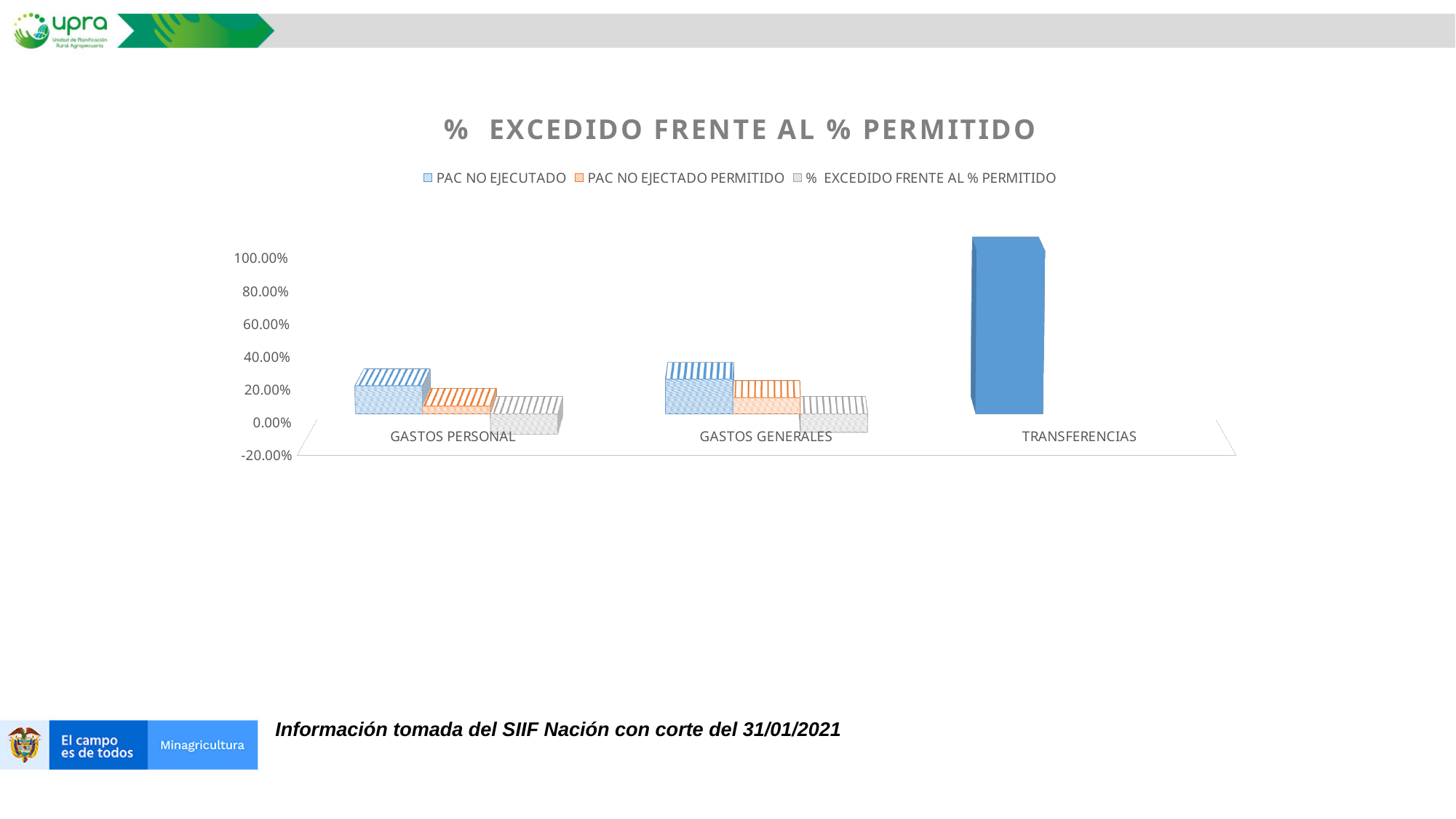
How many series does the chart legend list? 3 Is the PAC NO EJECTADO PERMITIDO value for GASTOS GENERALES greater or less than 40.00%? less Is the PAC NO EJECUTADO value for TRANSFERENCIAS greater or less than 80.00%? greater Is the PAC NO EJECUTADO value for GASTOS PERSONAL greater or less than 40.00%? less What is the title of the chart? % EXCEDIDO FRENTE AL % PERMITIDO For PAC NO EJECUTADO, which is larger: TRANSFERENCIAS or GASTOS GENERALES? TRANSFERENCIAS Which category has the lowest value for PAC NO EJECUTADO? GASTOS PERSONAL For GASTOS PERSONAL, which is larger: PAC NO EJECUTADO or % EXCEDIDO FRENTE AL % PERMITIDO? PAC NO EJECUTADO How many categories are shown on the x axis of the chart? 3 What kind of chart is shown on the slide? bar chart Which category has the highest value for PAC NO EJECUTADO? TRANSFERENCIAS Which series is shown in orange in the chart legend? PAC NO EJECTADO PERMITIDO